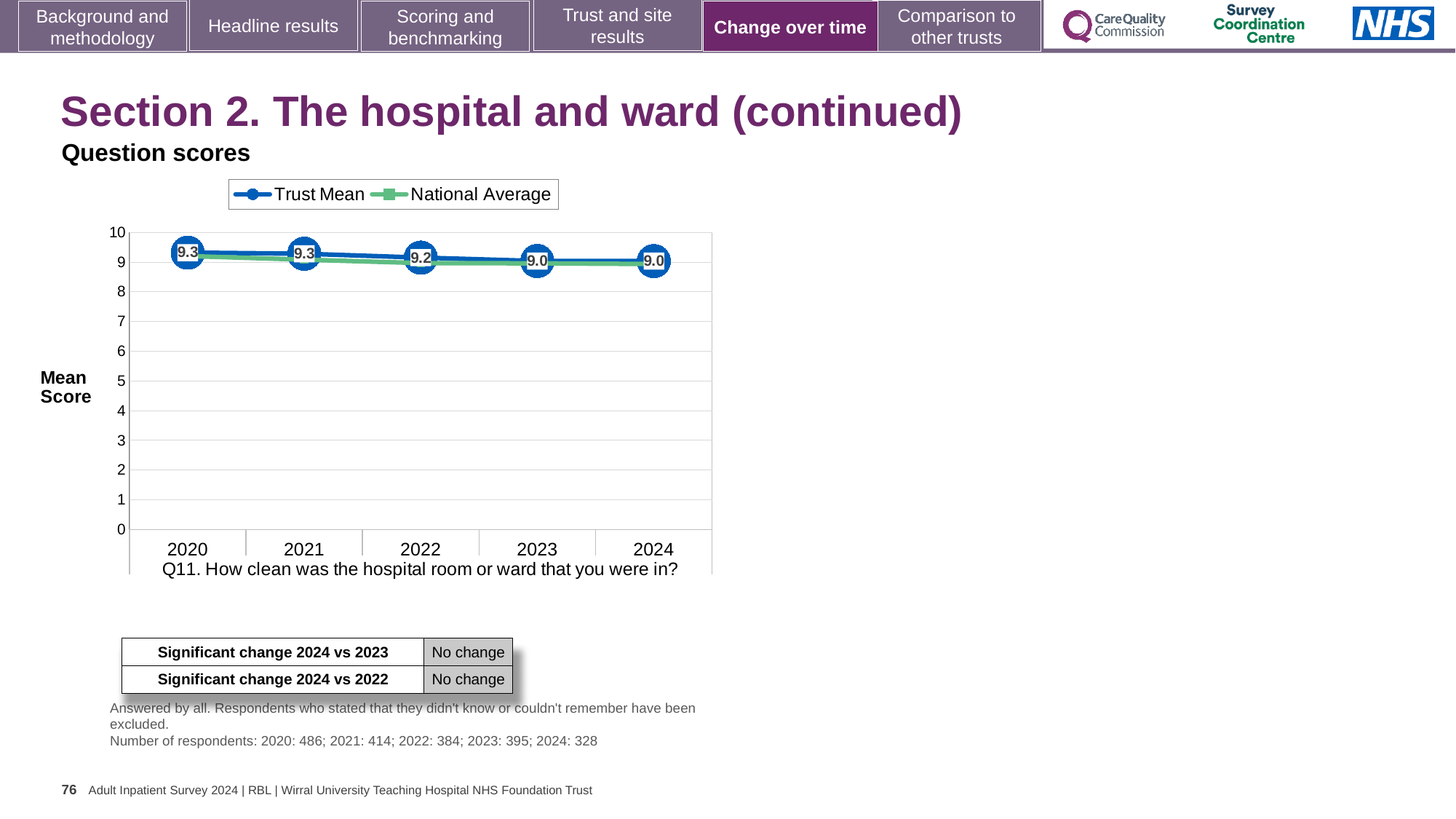
What is the difference between the Trust Mean in 2020 and in 2024? 0.3 How many series does the chart legend list? 2 What is the Trust Mean score for 2023? 9.0 What is the Trust Mean score for 2020? 9.3 Which survey question does the chart show scores for? Q11. How clean was the hospital room or ward that you were in? What is the Trust Mean score for 2022? 9.2 What kind of chart is shown on the slide? Line chart Does the Trust Mean rise or fall from 2020 to 2024? Fall What is the Trust Mean score for 2024? 9.0 Is the National Average value for 2024 greater or less than 8? greater How many years are plotted on the x axis? 5 Which is larger, the Trust Mean for 2021 or for 2023? 2021